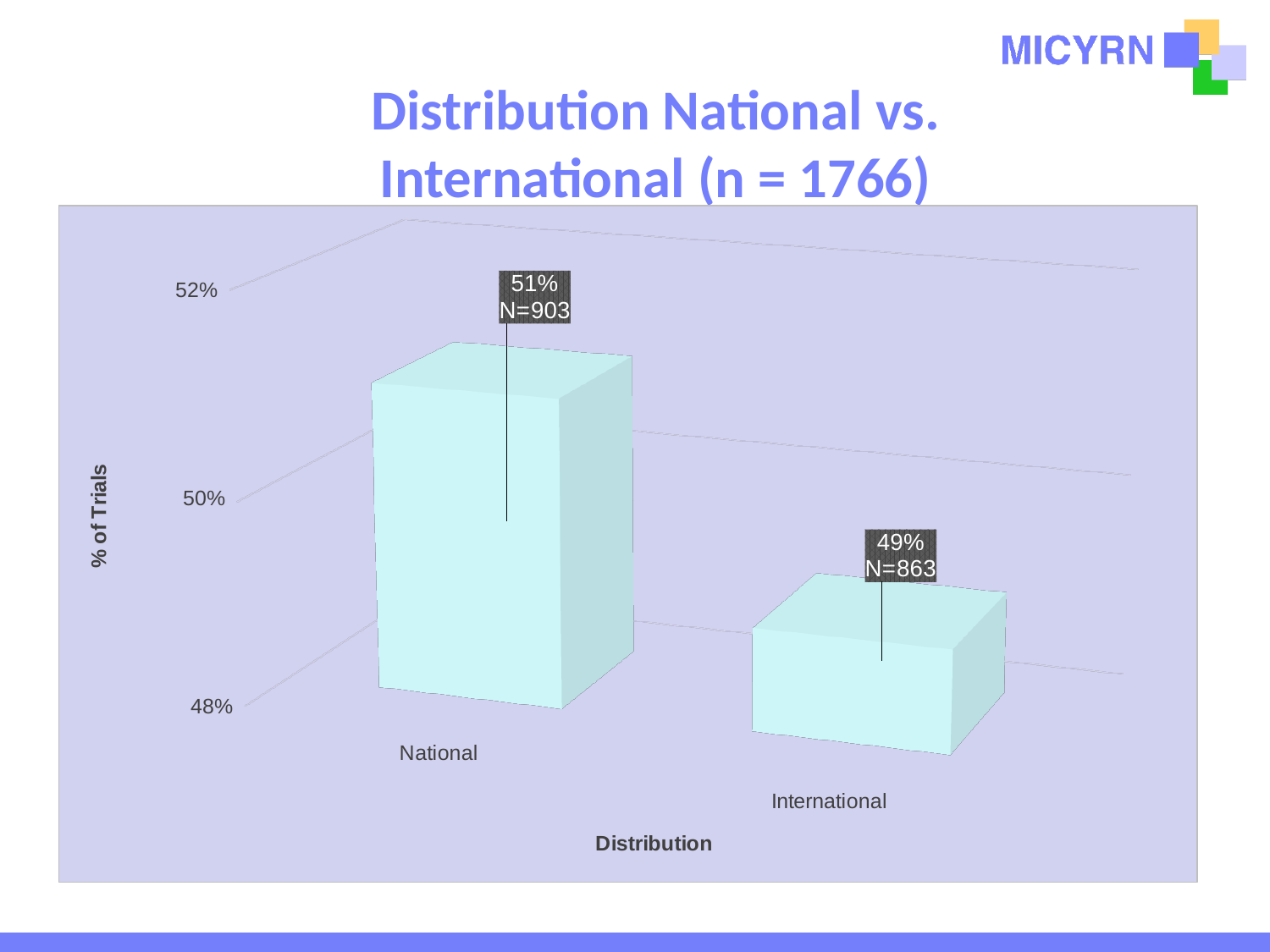
Which category has the lower percentage of trials? International What is the label of the y axis? % of Trials How many categories are shown on the x axis? 2 What is the difference in percentage points between National and International? 2% Which category has the higher percentage of trials? National What percentage of trials is shown for National? 51% What is the N value shown in the data label for International? N=863 Is the value for National greater or less than 50%? greater What is the N value shown in the data label for National? N=903 What kind of chart is shown on the slide? bar chart What percentage of trials is shown for International? 49% Is the value for International greater or less than 50%? less